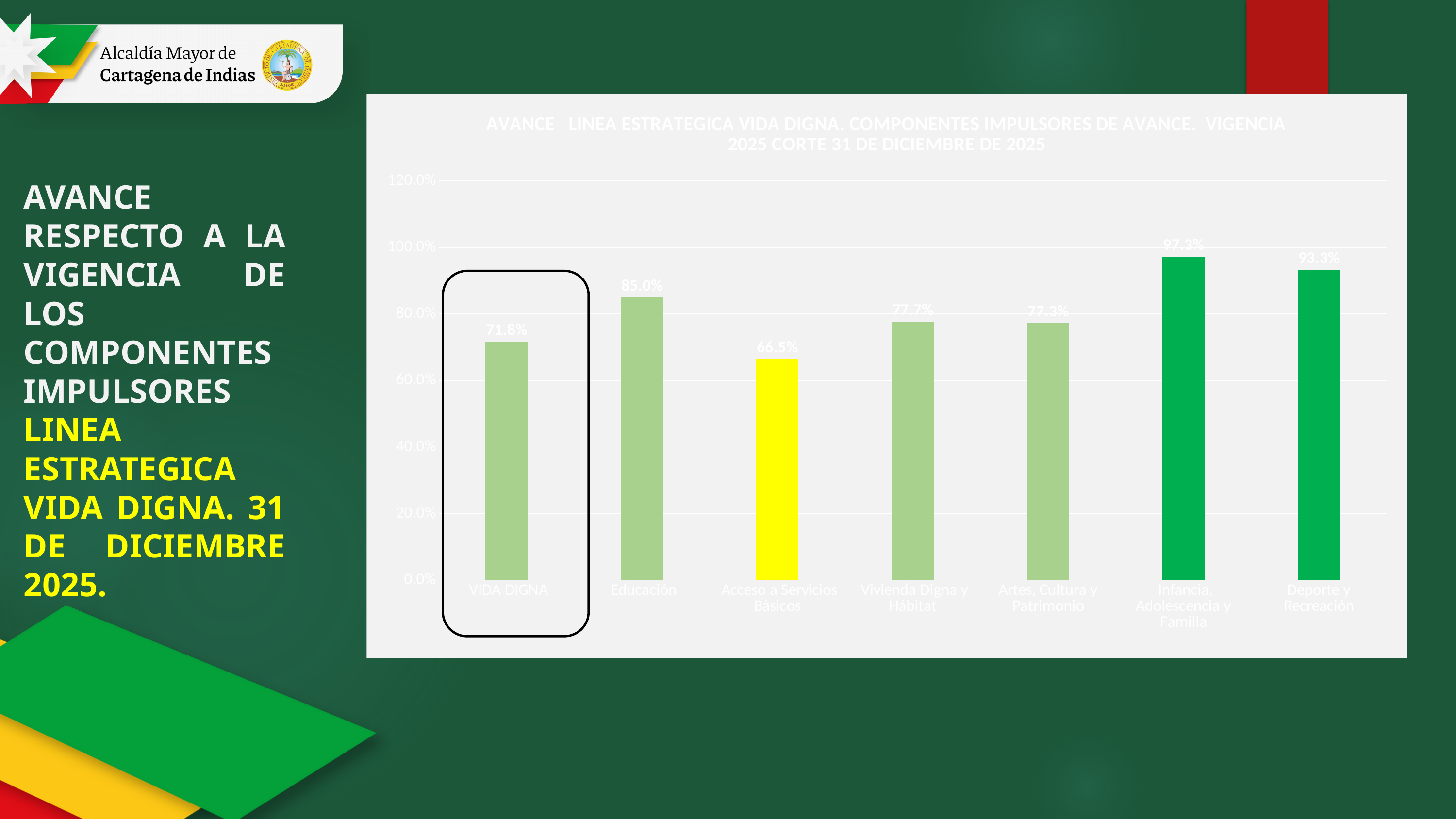
Which category has the lowest value? Acceso a Servicios Básicos What is the value for Deporte y Recreación? 93.3% Which category has the highest value? Infancia, Adolescencia y Familia What is the value for VIDA DIGNA? 71.8% Which bar is coloured yellow? Acceso a Servicios Básicos Which is larger, the value for Educación or the value for Vivienda Digna y Hábitat? Educación What is the value for Educación? 85.0% What is the value for Acceso a Servicios Básicos? 66.5% What kind of chart is shown on the slide? bar chart Is the value for Artes, Cultura y Patrimonio greater or less than 80.0%? less How many categories are shown on the x axis? 7 What is the difference between the values for Infancia, Adolescencia y Familia and Deporte y Recreación? 4.0%